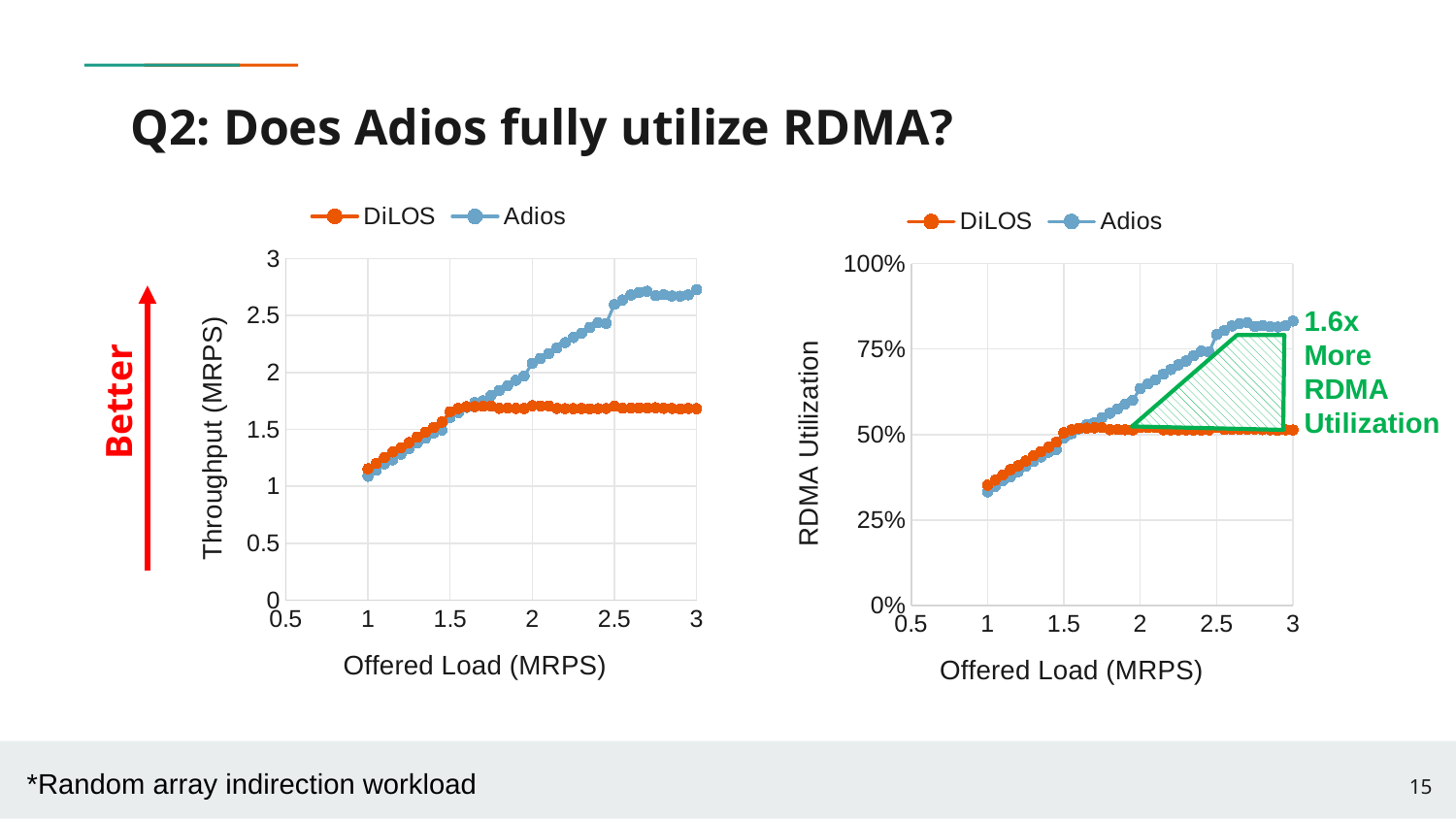
In the right chart (RDMA Utilization), is the Adios utilization at an offered load of 3 MRPS greater or less than 75%? greater In the left chart (Throughput), does the Adios throughput rise or fall as offered load increases from 1 to 3 MRPS? rise In the left chart (Throughput), is the DiLOS throughput at an offered load of 3 MRPS greater or less than 2? less What kind of chart is the left chart showing Throughput (MRPS) against Offered Load? line chart In the right chart (RDMA Utilization), is the Adios utilization at an offered load of 1 MRPS greater or less than 25%? greater What is the y-axis title of the right chart? RDMA Utilization How many series does the legend of the right chart (RDMA Utilization) list? 2 In the right chart (RDMA Utilization), which series has the higher utilization at an offered load of 3 MRPS, DiLOS or Adios? Adios In the left chart (Throughput), which series reaches the higher throughput at an offered load of 3 MRPS, DiLOS or Adios? Adios What is the x-axis title of the left chart? Offered Load (MRPS)